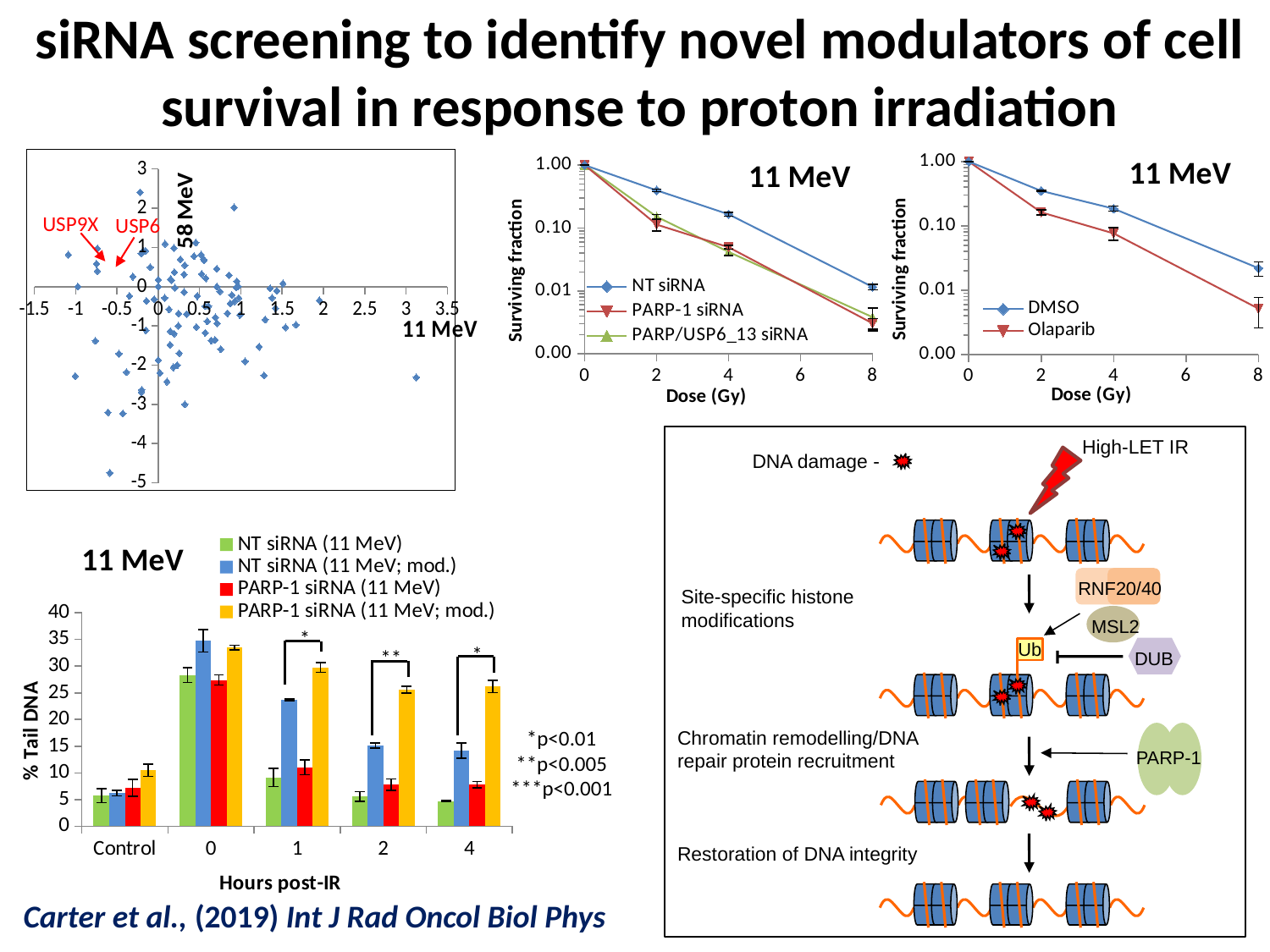
What kind of chart is the top-left chart with axes labelled 11 MeV and 58 MeV? scatter plot In the bar chart (% Tail DNA), is the value for NT siRNA (11 MeV) at 2 hours post-IR greater or less than 10? less In the bar chart (% Tail DNA), which series has the highest value in the Control category? PARP-1 siRNA (11 MeV; mod.) In the bar chart (% Tail DNA), does the NT siRNA (11 MeV; mod.) series rise or fall from 0 to 4 hours post-IR? fall In the bar chart (% Tail DNA), at 1 hour post-IR, which is larger: NT siRNA (11 MeV; mod.) or PARP-1 siRNA (11 MeV; mod.)? PARP-1 siRNA (11 MeV; mod.) In the bar chart (% Tail DNA), is the value for NT siRNA (11 MeV; mod.) at 0 hours post-IR greater or less than 30? greater In the right surviving fraction line chart (DMSO and Olaparib), which series has the larger value at a dose of 8 Gy? DMSO In the left surviving fraction line chart, does the NT siRNA series rise or fall as dose increases? fall How many categories are shown on the x axis of the bar chart (% Tail DNA vs Hours post-IR)? 5 In the right surviving fraction line chart, is the value for DMSO at 2 Gy greater or less than 0.10? greater How many series does the legend of the left surviving fraction line chart (with NT siRNA) list? 3 How many series does the legend of the bar chart (% Tail DNA vs Hours post-IR) list? 4